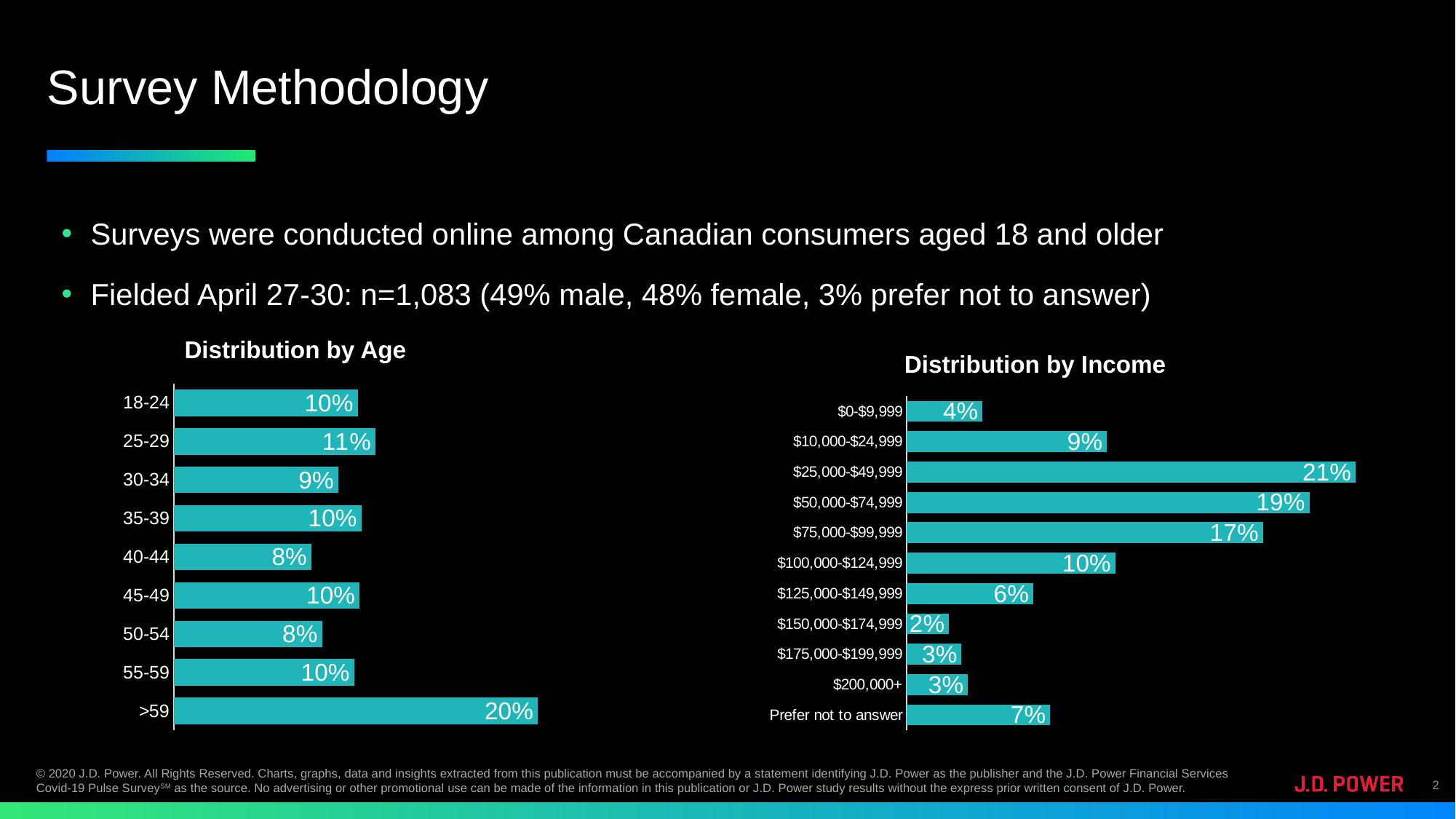
In the Distribution by Income chart, what is the value for $25,000-$49,999? 21% In the Distribution by Income chart, which income category has the lowest value? $150,000-$174,999 In the Distribution by Income chart, how many income categories are shown? 11 What type of chart is the Distribution by Income chart? Bar chart In the Distribution by Age chart, how many age categories are shown? 9 In the Distribution by Age chart, which is larger, the value for 25-29 or the value for 30-34? 25-29 In the Distribution by Age chart, what is the value for the >59 age group? 20% In the Distribution by Income chart, what is the difference between $50,000-$74,999 and $75,000-$99,999? 2% In the Distribution by Income chart, which income category has the highest value? $25,000-$49,999 In the Distribution by Income chart, what is the value for Prefer not to answer? 7% In the Distribution by Age chart, which age group has the highest value? >59 In the Distribution by Age chart, what is the difference between the >59 group and the 25-29 group? 9%